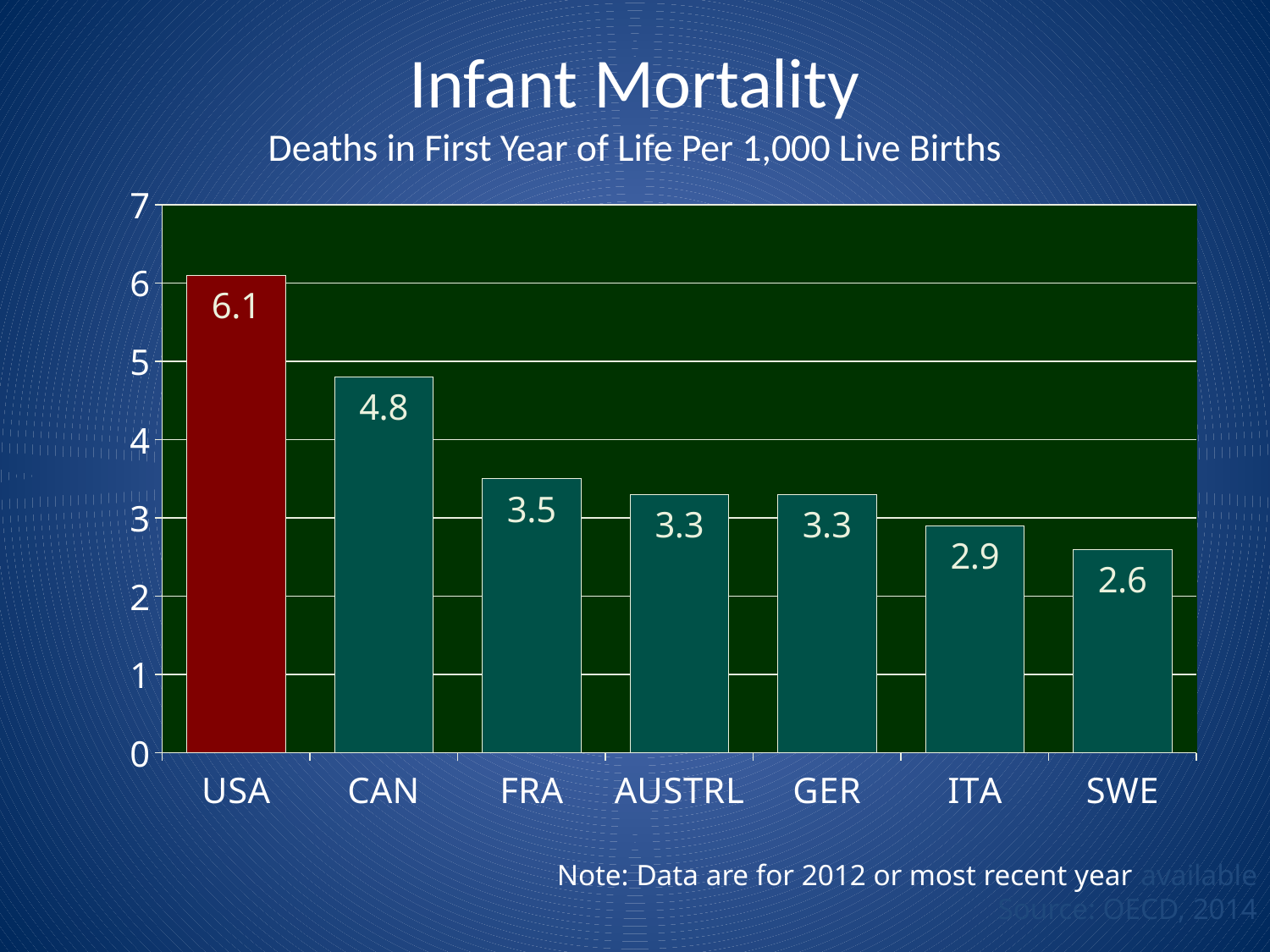
What is the difference between the USA and CAN values? 1.3 What kind of chart is shown on the slide? bar chart Which bar is coloured differently (red) from the others? USA How many countries are shown on the chart? 7 Which country has the highest infant mortality rate? USA Is the value for ITA greater or less than 3? less What is the difference between the FRA and ITA values? 0.6 Which is larger, the value for CAN or the value for FRA? CAN What is the infant mortality value for CAN? 4.8 What is the infant mortality value for SWE? 2.6 What is the infant mortality value for the USA? 6.1 Which country has the lowest infant mortality rate? SWE